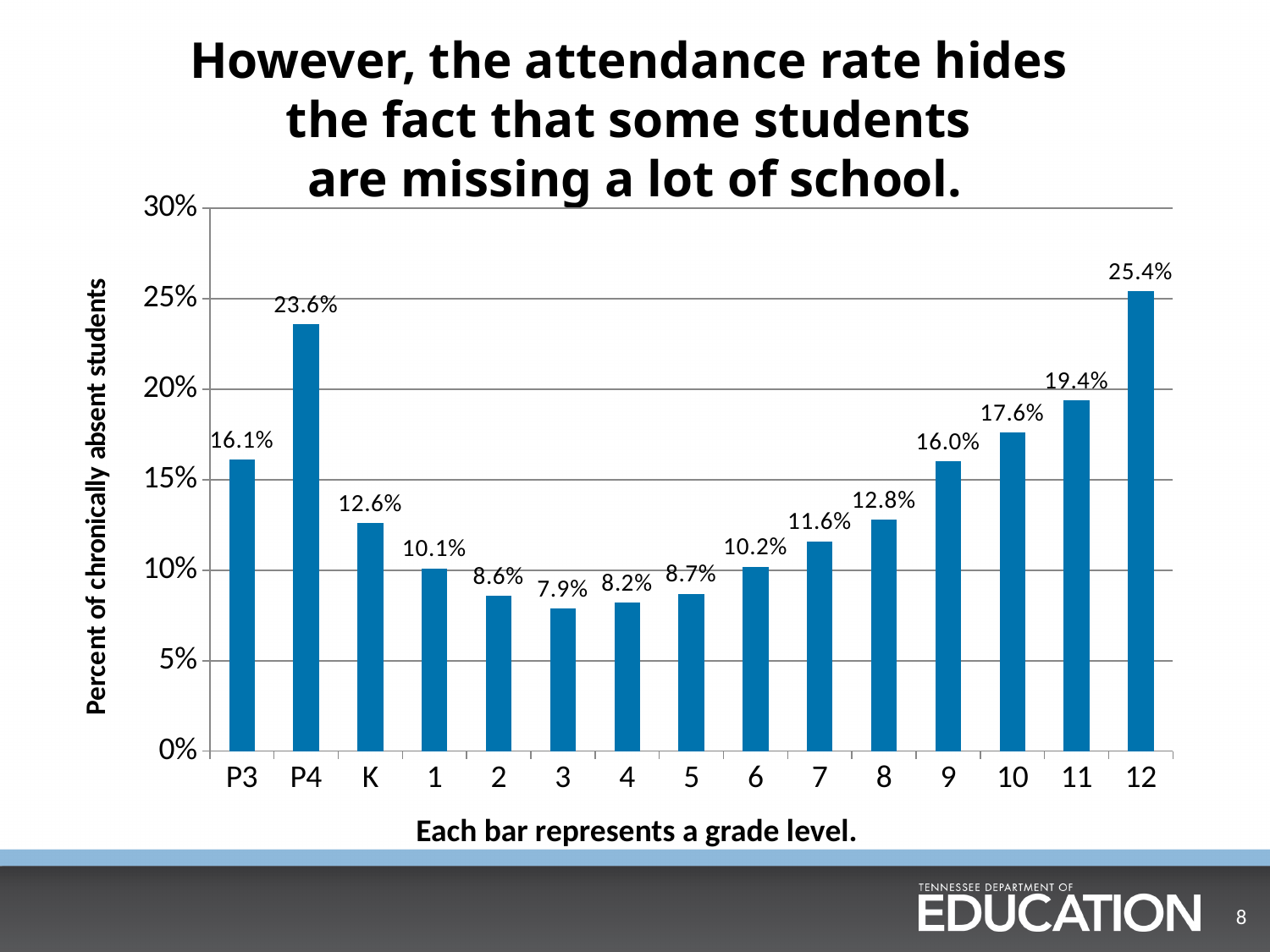
Which has a higher percent of chronically absent students, grade 9 or grade 8? 9 Do the values rise or fall from grade 3 to grade 12? rise What is the percent of chronically absent students for grade 3? 7.9% Is the percent of chronically absent students for grade 11 greater or less than 20%? less What is the difference between the percent of chronically absent students in P4 and P3? 7.5% Which grade level has the highest percent of chronically absent students? 12 What is the percent of chronically absent students for grade 12? 25.4% Which grade level has the lowest percent of chronically absent students? 3 What is the difference between the percent of chronically absent students in grade 12 and grade 3? 17.5% What kind of chart is shown on the slide? bar chart How many grade levels are shown on the chart? 15 What is the percent of chronically absent students for grade K? 12.6%